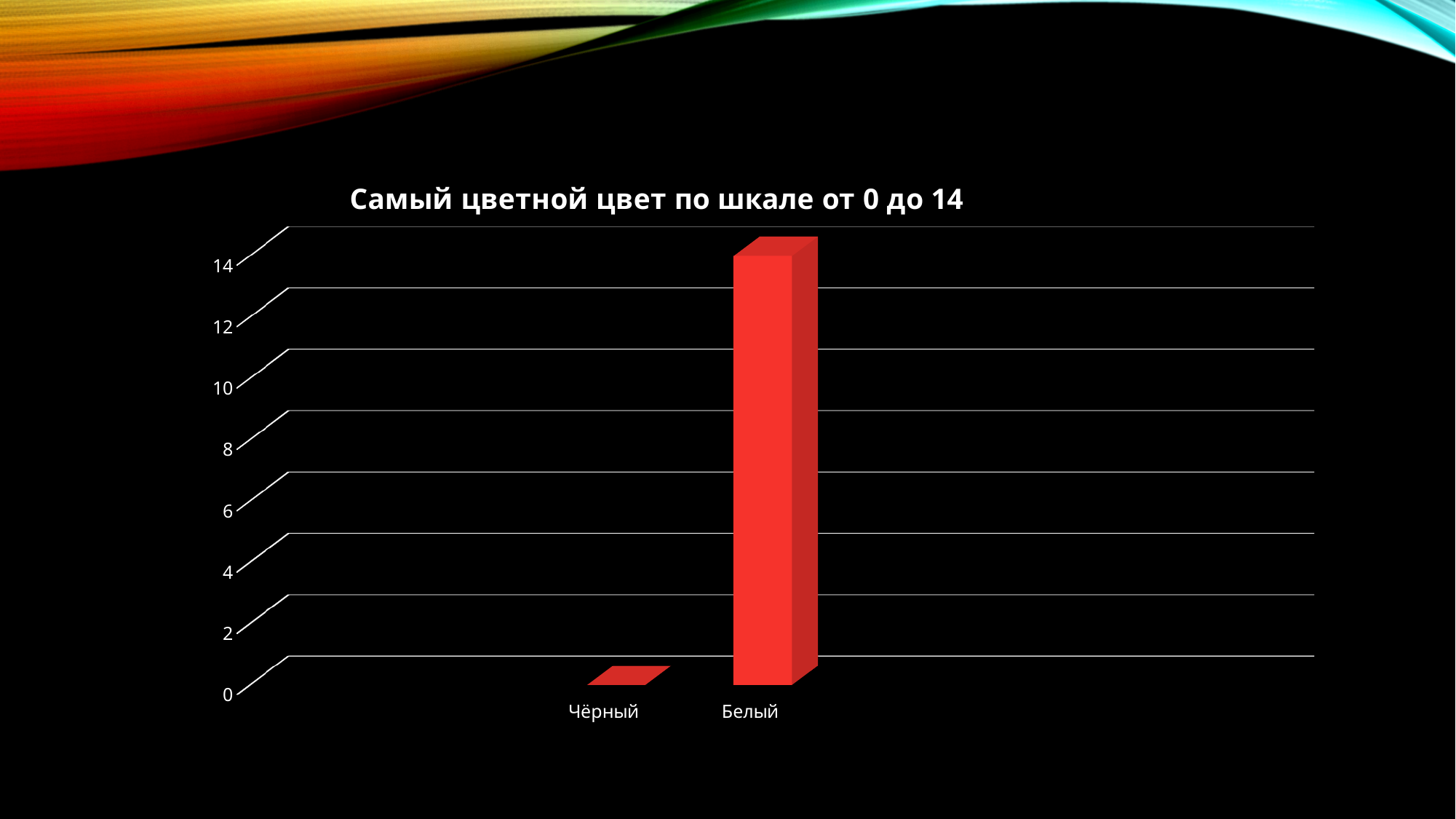
Which category has the highest value? Белый What kind of chart is shown on the slide? bar chart Is the value for Чёрный greater or less than 2? less Which category has the lowest value? Чёрный Do the values rise or fall from Чёрный to Белый along the x axis? rise How many categories are plotted in the chart? 2 Is the value for Белый greater or less than 12? greater Is the value for Белый greater or less than 8? greater Which is larger, the value for Чёрный or the value for Белый? Белый What is the title of the chart? Самый цветной цвет по шкале от 0 до 14 What is the highest value shown on the vertical axis? 14